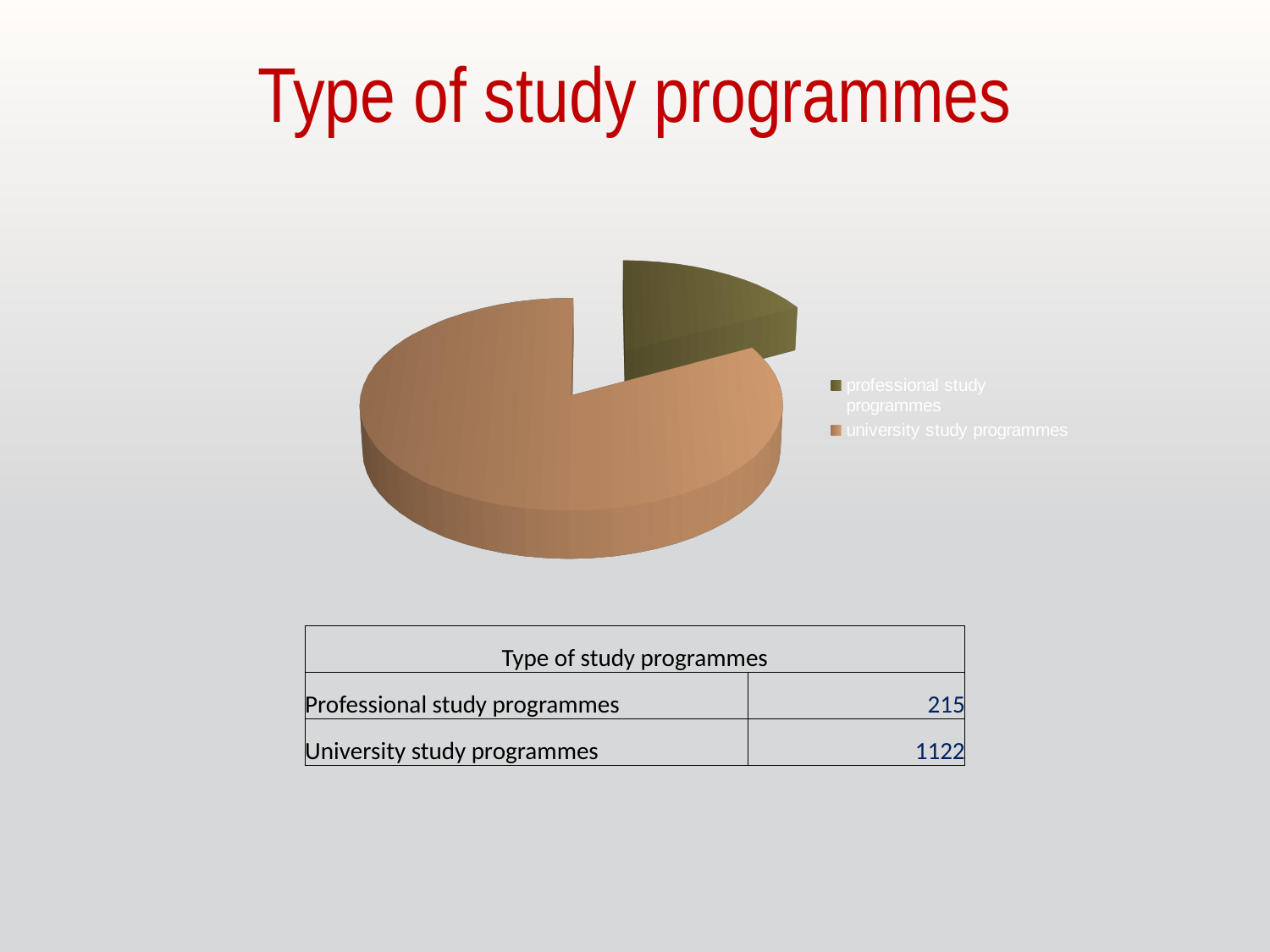
What is the title of the slide containing the pie chart? Type of study programmes Which is larger, the value for professional study programmes or the value for university study programmes? university study programmes How many entries does the legend of the pie chart list? 2 What is the difference between the value for university study programmes and the value for professional study programmes? 907 Which legend entry is shown in the dark green colour? professional study programmes What is the value for university study programmes? 1122 What kind of chart is shown on the slide? pie chart How many slices does the pie chart have? 2 Which category has the largest slice of the pie? university study programmes What is the value for professional study programmes? 215 Which category has the smallest slice of the pie? professional study programmes What is the total of the two values shown in the table below the chart? 1337